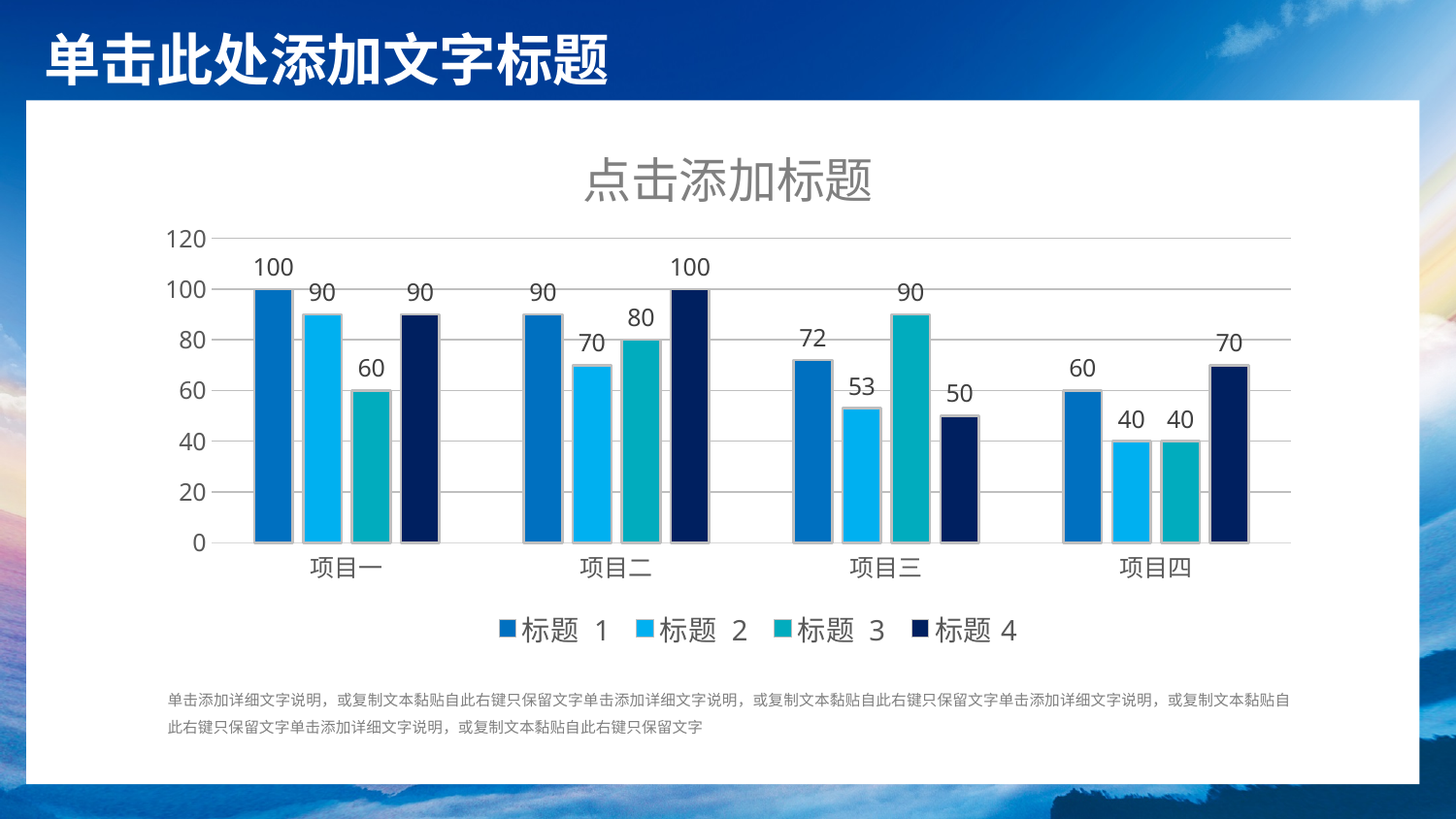
What is the title of the chart? 点击添加标题 What is the difference between 标题 1 and 标题 3 for 项目一? 40 For 项目三, which is larger: 标题 1 or 标题 3? 标题 3 What kind of chart is shown on the slide? Bar chart How many categories are shown on the x axis? 4 What is the value of 标题 1 for 项目一? 100 Which category has the highest value for 标题 4? 项目二 What is the value of 标题 3 for 项目二? 80 What is the value of 标题 2 for 项目三? 53 Which category has the lowest value for 标题 1? 项目四 What is the value of 标题 4 for 项目四? 70 How many series does the legend list? 4